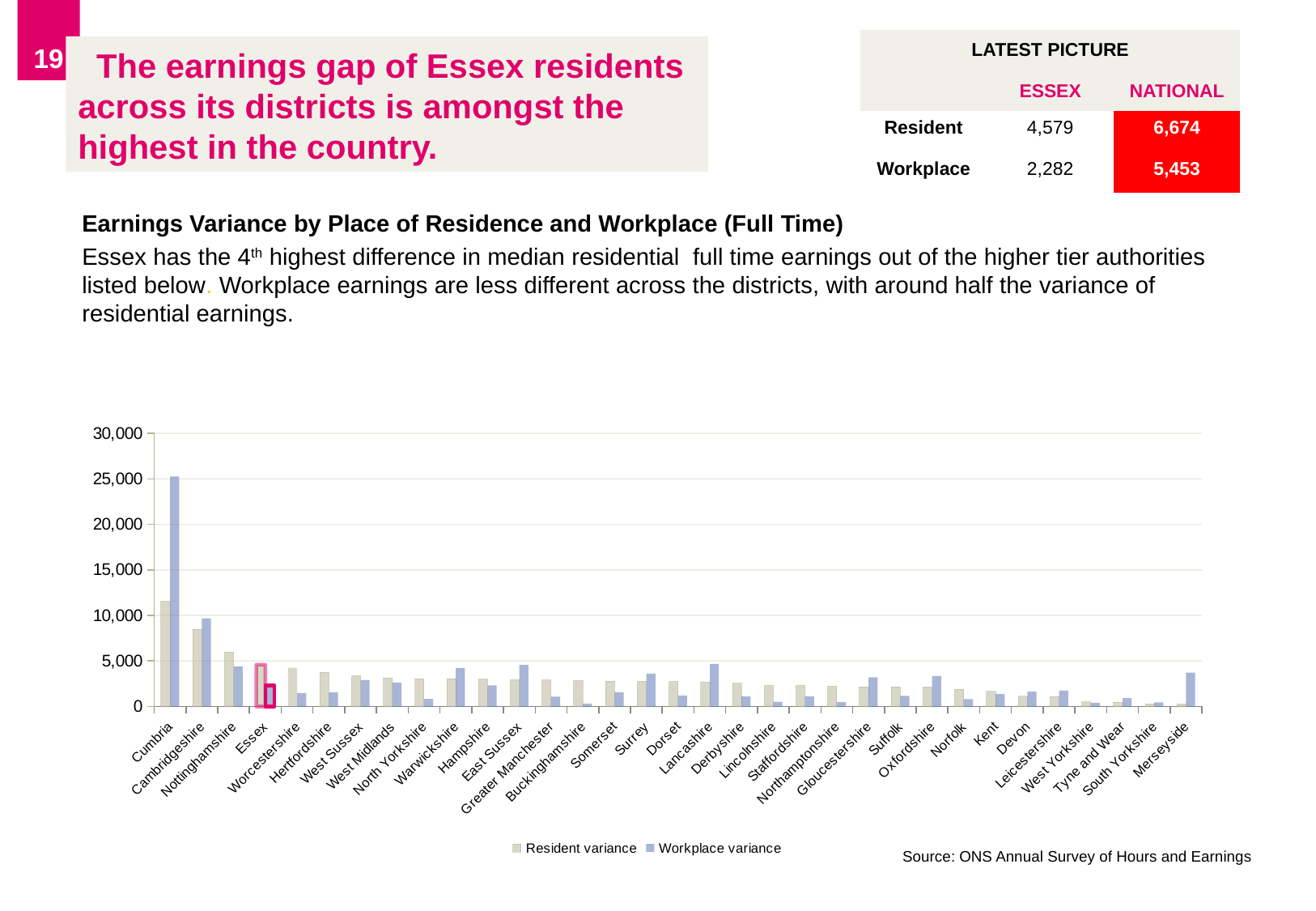
How many series does the legend list? 2 Is the Resident variance for Merseyside greater or less than 5,000? less Is the Resident variance for Nottinghamshire greater or less than 5,000? greater Does the Resident variance generally rise or fall from left to right across the x axis? fall For Lancashire, which is larger: Resident variance or Workplace variance? Workplace variance Is the Workplace variance for Cumbria greater or less than 20,000? greater What kind of chart is shown on the slide? bar chart Which authority has the highest Resident variance? Cumbria Which authority has the highest Workplace variance? Cumbria For Essex, which is larger: Resident variance or Workplace variance? Resident variance How many authorities are shown along the x axis of the chart? 33